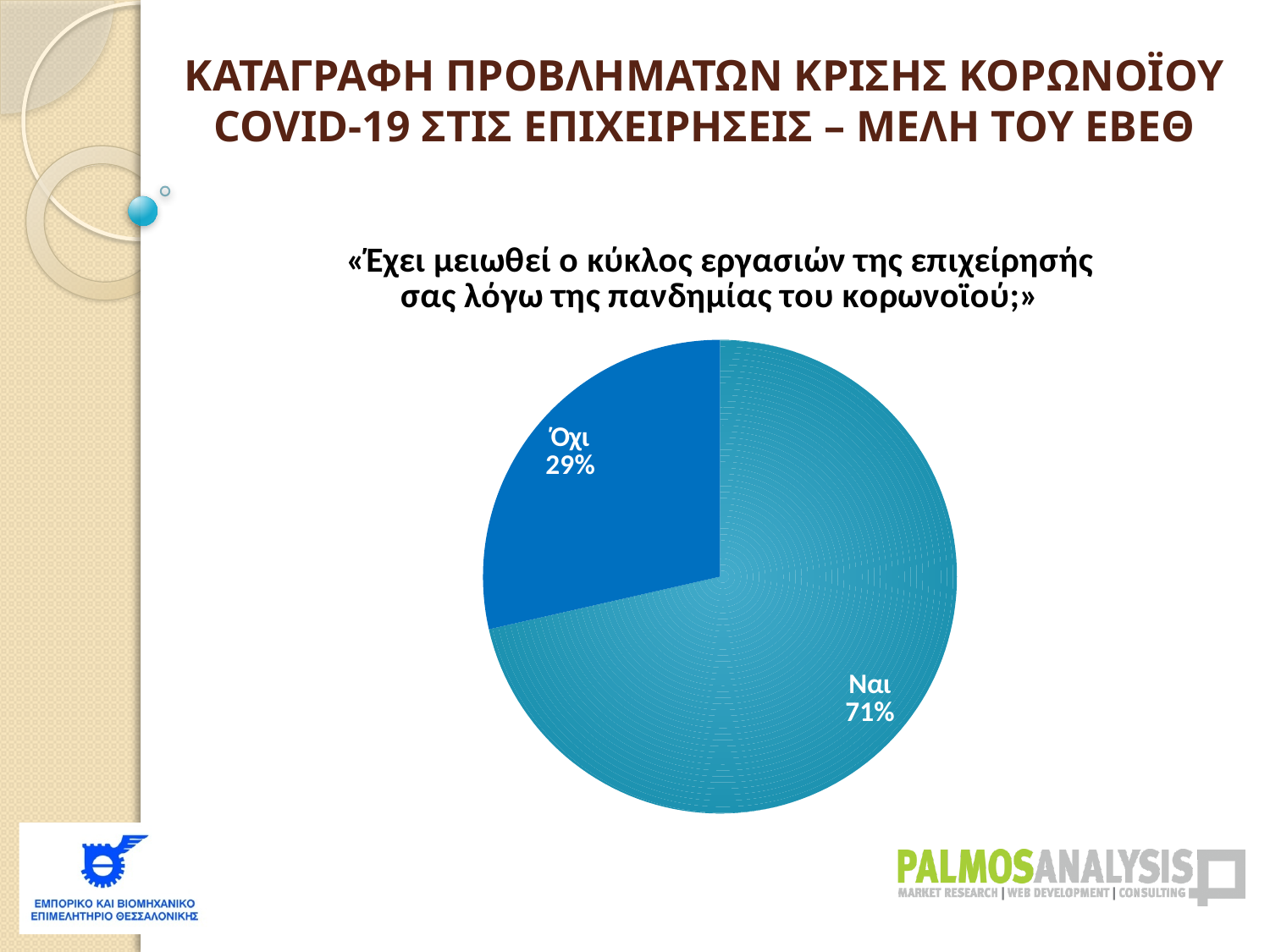
Which slice is shown in the darker blue colour? Όχι Which slice is larger, "Ναι" or "Όχι"? Ναι Which response has the smallest share of the pie? Όχι How many slices does the pie chart have? 2 Which response has the largest share of the pie? Ναι What is the difference in percentage points between the "Ναι" and "Όχι" slices? 42 What kind of chart is shown on the slide? pie chart What question does the pie chart answer, according to the text above it? «Έχει μειωθεί ο κύκλος εργασιών της επιχείρησής σας λόγω της πανδημίας του κορωνοϊού;» What percentage of respondents answered "Όχι"? 29% What percentage of respondents answered "Ναι"? 71% What share of the pie does the "Όχι" slice represent? 29%